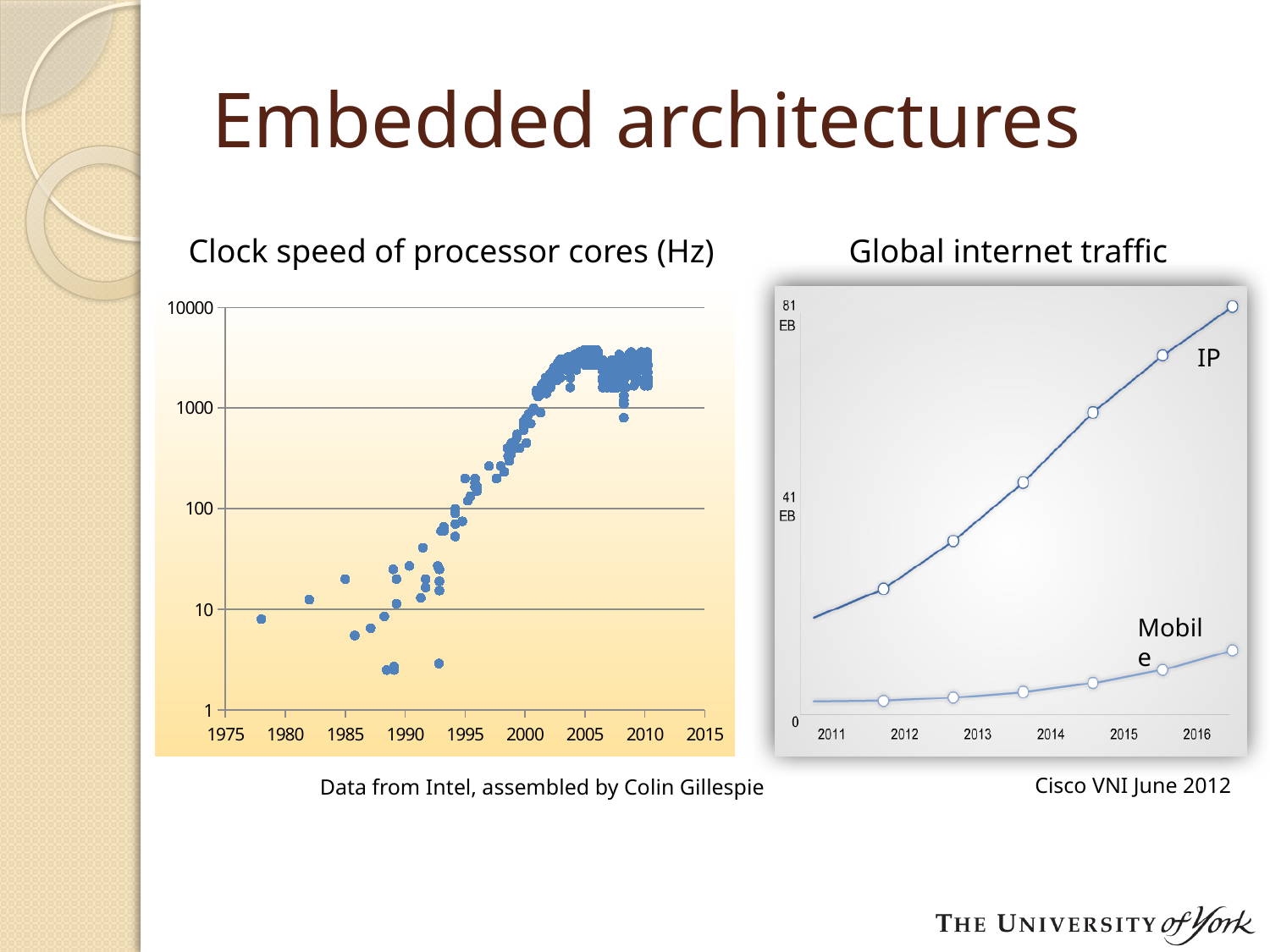
In the 'Global internet traffic' chart, what are the two series labelled? IP and Mobile What kind of chart is the 'Clock speed of processor cores (Hz)' chart on the left? scatter plot In the 'Global internet traffic' chart, which series is higher in 2016, IP or Mobile? IP What is the title of the chart on the right of the slide? Global internet traffic In the 'Global internet traffic' chart, is the Mobile value for 2016 greater or less than 41 EB? less In the 'Clock speed of processor cores (Hz)' chart, do clock speeds generally rise or fall from 1975 to 2005? rise In the 'Global internet traffic' chart, how many series are plotted? 2 In the 'Global internet traffic' chart, does the IP series rise or fall from 2011 to 2016? rise In the 'Clock speed of processor cores (Hz)' chart, is the clock speed of the earliest point (around 1978) greater or less than 10 Hz? less In the 'Clock speed of processor cores (Hz)' chart, are the clock speeds around 2005 greater or less than 1000 Hz? greater What kind of chart is the 'Global internet traffic' chart on the right? line chart